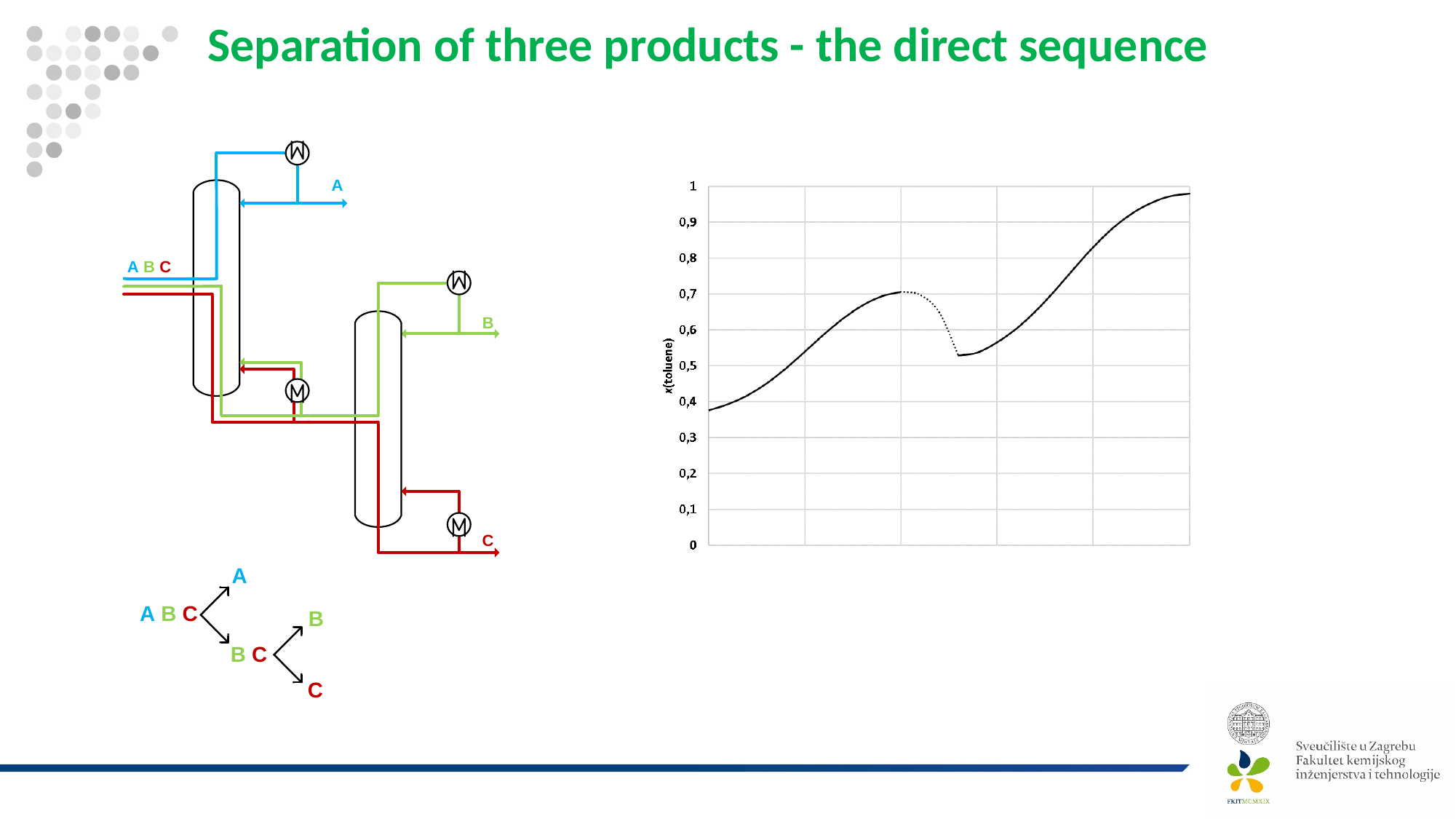
Is the lowest value of x(toluene) in the dip after the first hump greater or less than 0.4? greater What is the highest tick value shown on the y axis of the chart? 1 Is the value of x(toluene) at the right end of the curve greater or less than 0.9? greater Is the value of x(toluene) at the left end of the curve greater or less than 0.5? less Comparing the left end and the right end of the curve, which has the larger value of x(toluene)? the right end How many lines (series) are plotted on the chart? 1 Overall, from the left end to the right end of the chart, does x(toluene) rise or fall? rise What kind of chart is shown on the right side of the slide? line chart What is the label on the y axis of the chart? x(toluene)